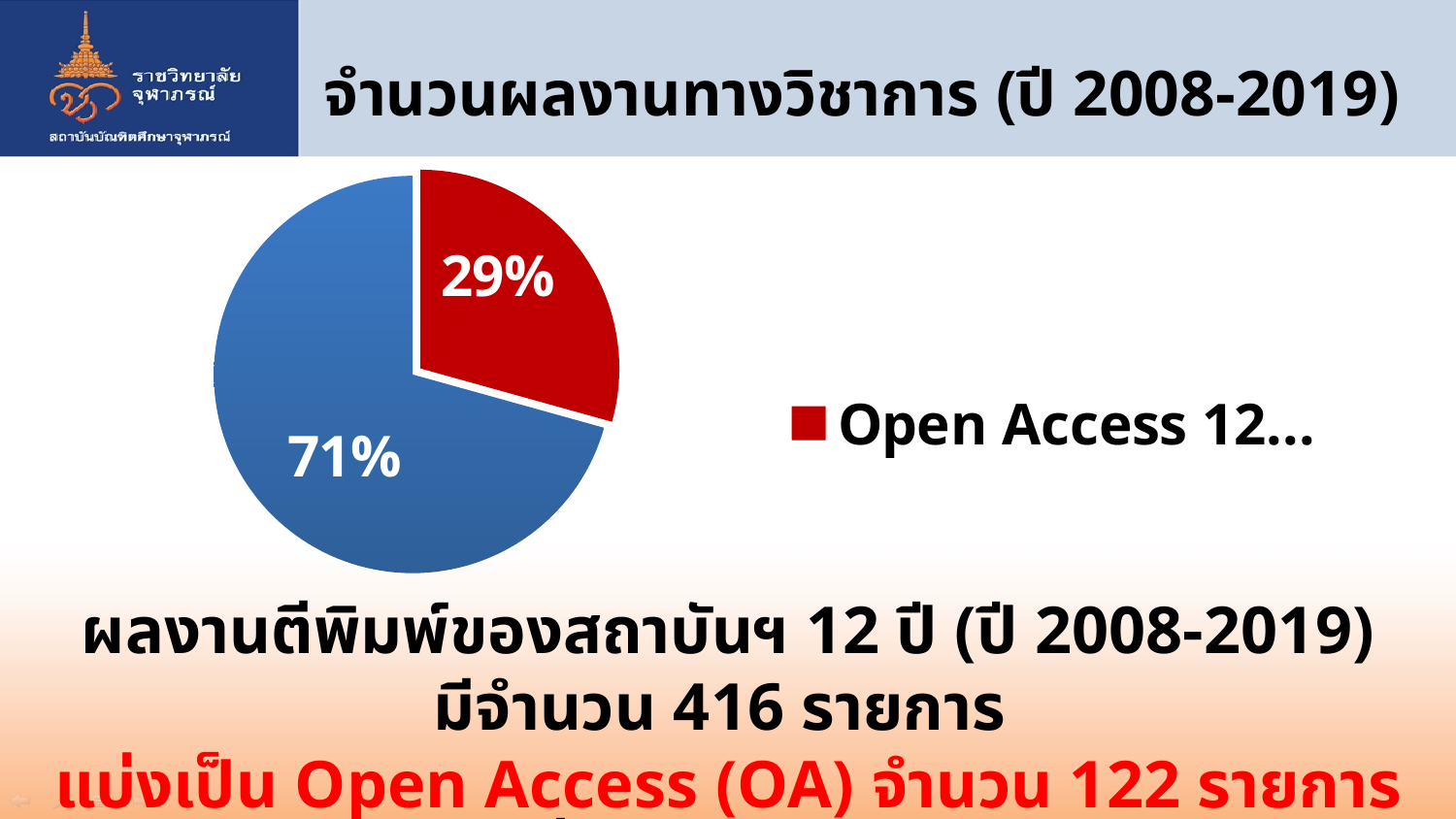
Which is larger, the red slice or the blue slice? the blue slice Which slice of the pie chart is the largest? the blue slice (71%) What kind of chart is shown on the slide? pie chart Is the share of the red slice greater or less than 50%? less What is the title of the slide containing the pie chart? จำนวนผลงานทางวิชาการ (ปี 2008-2019) What share of the pie does the red slice (Open Access) represent? 29% How many slices does the pie chart have? 2 What is the difference in percentage points between the blue slice and the red slice? 42 What percentage is printed on the Open Access slice of the pie chart? 29% What colour is the Open Access slice in the pie chart? red What share of the pie does the blue slice represent? 71% Which slice of the pie chart is the smallest? the red Open Access slice (29%)